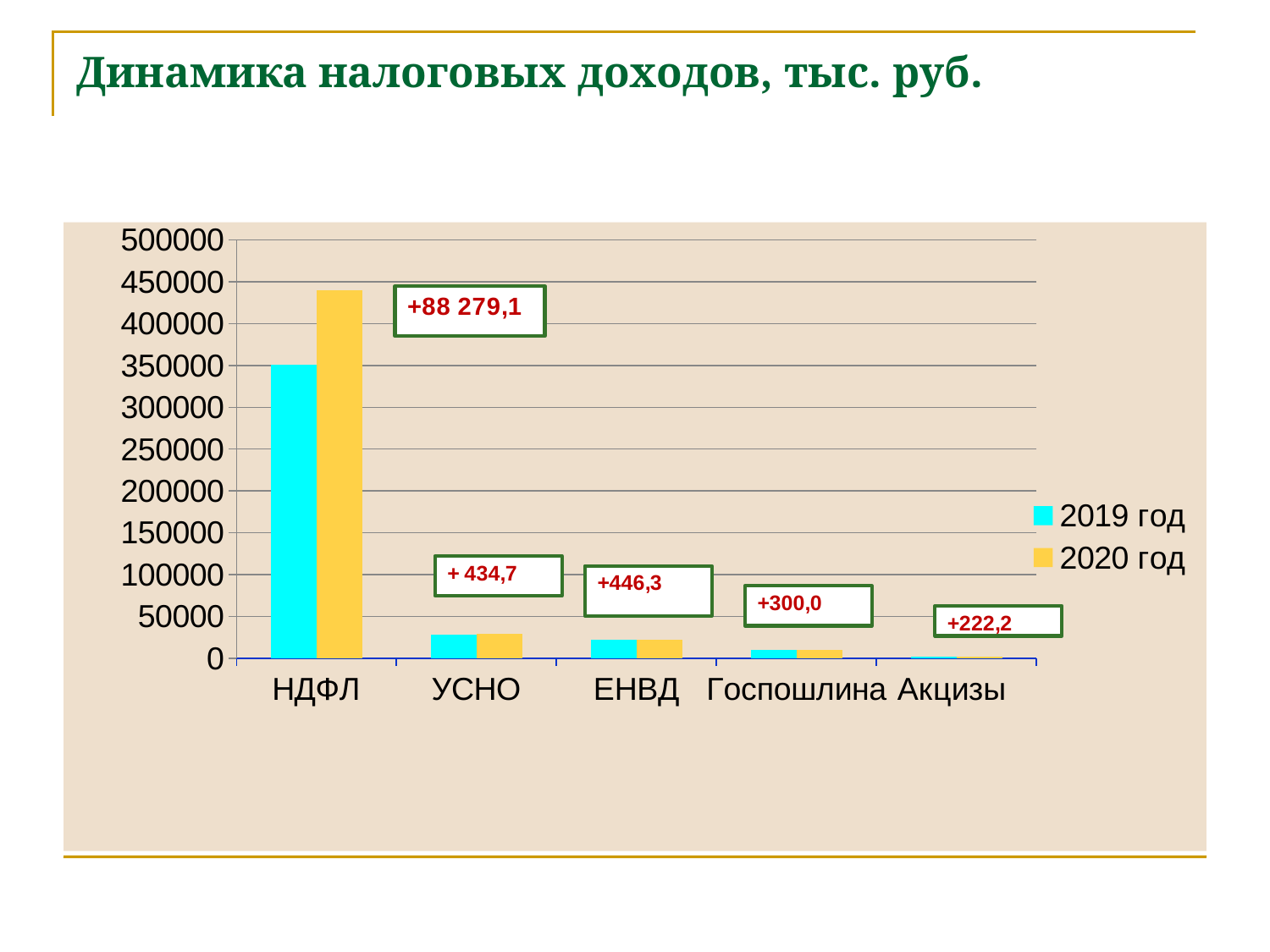
What change is annotated above the Акцизы bars? +222,2 How many categories are shown on the x axis? 5 Is the value for НДФЛ in 2020 год greater or less than 400000? greater What is the title of the chart on the slide? Динамика налоговых доходов, тыс. руб. Is the value for УСНО in 2020 год greater or less than 50000? less What type of chart is shown on the slide? bar chart Which is larger for НДФЛ: the 2019 год value or the 2020 год value? 2020 год What change is annotated above the НДФЛ bars? +88 279,1 Which category has the highest value for 2020 год? НДФЛ How many series does the legend list? 2 What change is annotated above the Госпошлина bars? +300,0 Which category has the lowest value for 2019 год? Акцизы